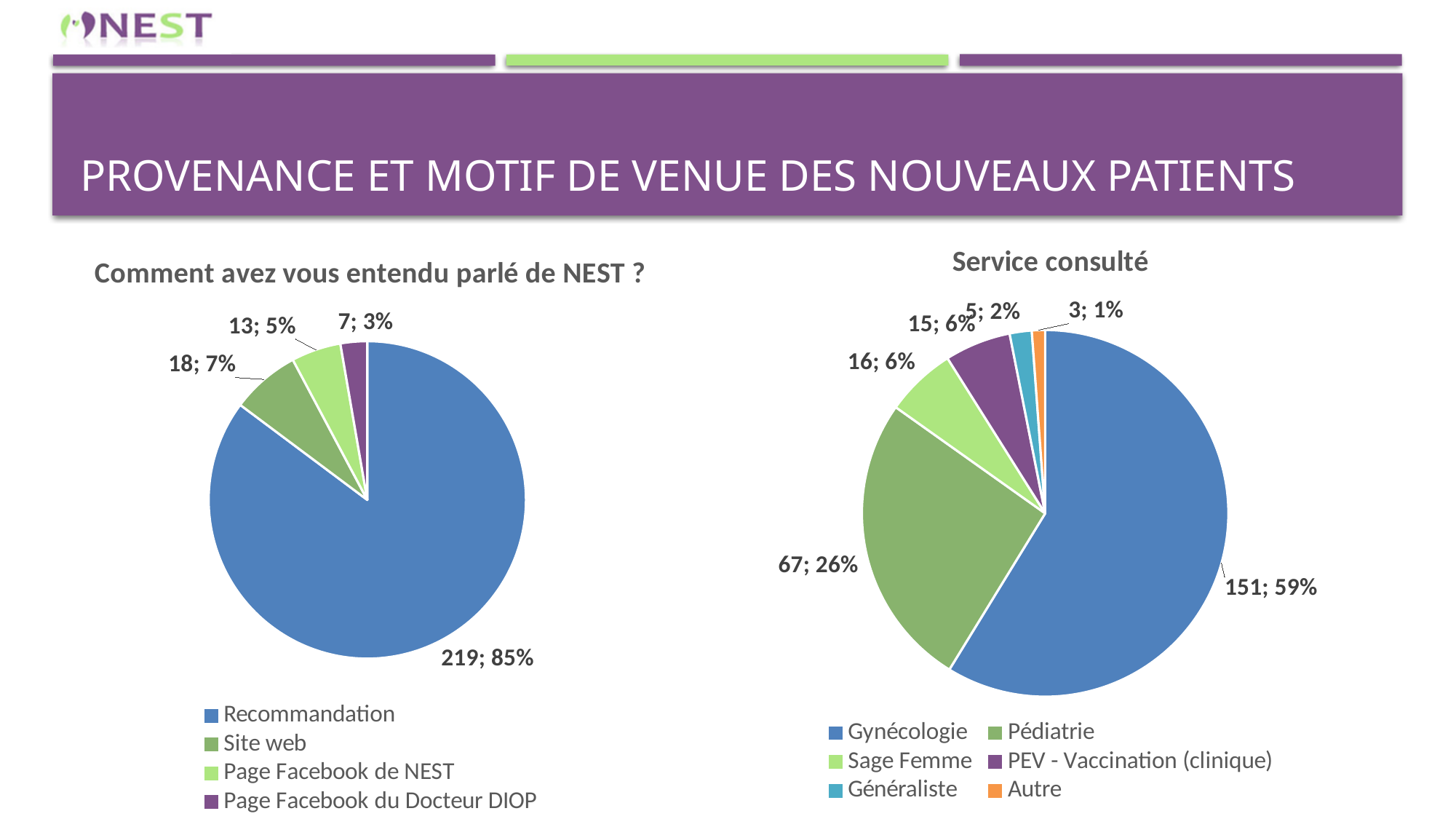
How many categories does the legend of the 'Comment avez vous entendu parlé de NEST ?' chart list? 4 In the 'Service consulté' chart, which service has the smallest share? Autre In the 'Service consulté' chart, which service has the largest share? Gynécologie In the 'Service consulté' chart, what is the difference between the counts for Gynécologie and Pédiatrie? 84 In the 'Comment avez vous entendu parlé de NEST ?' chart, what is the value for Recommandation? 219; 85% In the 'Comment avez vous entendu parlé de NEST ?' chart, which category is the smallest? Page Facebook du Docteur DIOP In the 'Service consulté' chart, which is larger: Sage Femme or PEV - Vaccination (clinique)? Sage Femme What kind of chart is the 'Comment avez vous entendu parlé de NEST ?' chart? Pie chart In the 'Comment avez vous entendu parlé de NEST ?' chart, what is the difference between the counts for Site web and Page Facebook de NEST? 5 In the 'Service consulté' chart, what is the value for Pédiatrie? 67; 26% In the 'Comment avez vous entendu parlé de NEST ?' chart, what share of the pie does Site web represent? 7% How many categories does the legend of the 'Service consulté' chart list? 6